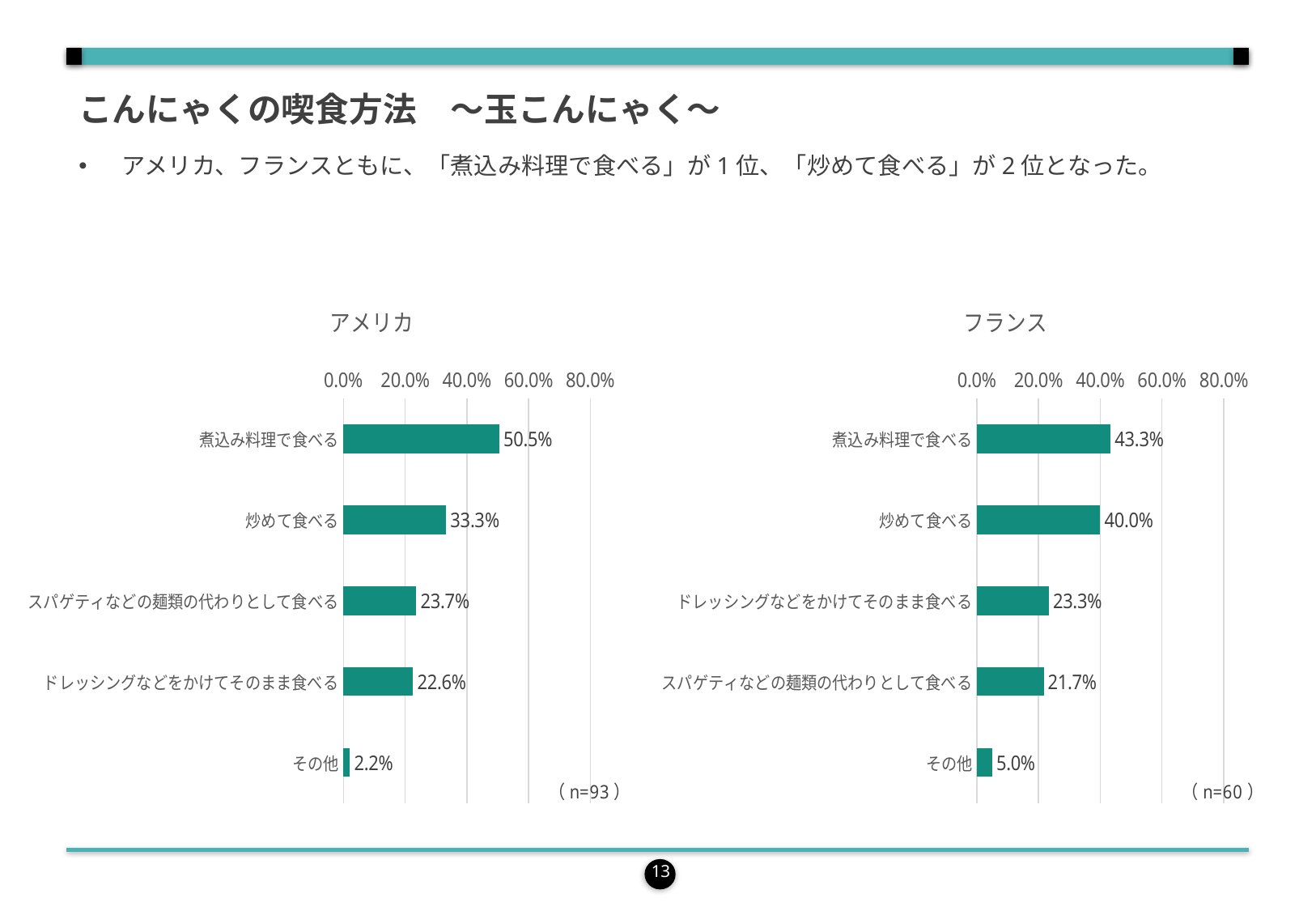
In the アメリカ chart, is the value for 炒めて食べる greater or less than 40.0%? less What is the sample size (n) shown for the フランス chart? n=60 How many categories are shown in the フランス chart? 5 In the フランス chart, what is the difference between ドレッシングなどをかけてそのまま食べる and スパゲティなどの麺類の代わりとして食べる? 1.6% In the アメリカ chart, what is the difference between 煮込み料理で食べる and 炒めて食べる? 17.2% In the アメリカ chart, what is the value for 煮込み料理で食べる? 50.5% In the フランス chart, which category has the lowest value? その他 In the フランス chart, what is the value for その他? 5.0% In the アメリカ chart, which category has the highest value? 煮込み料理で食べる In the フランス chart, what is the value for 炒めて食べる? 40.0% What kind of chart is the アメリカ chart? bar chart Which is larger: 煮込み料理で食べる in the アメリカ chart or 煮込み料理で食べる in the フランス chart? アメリカ